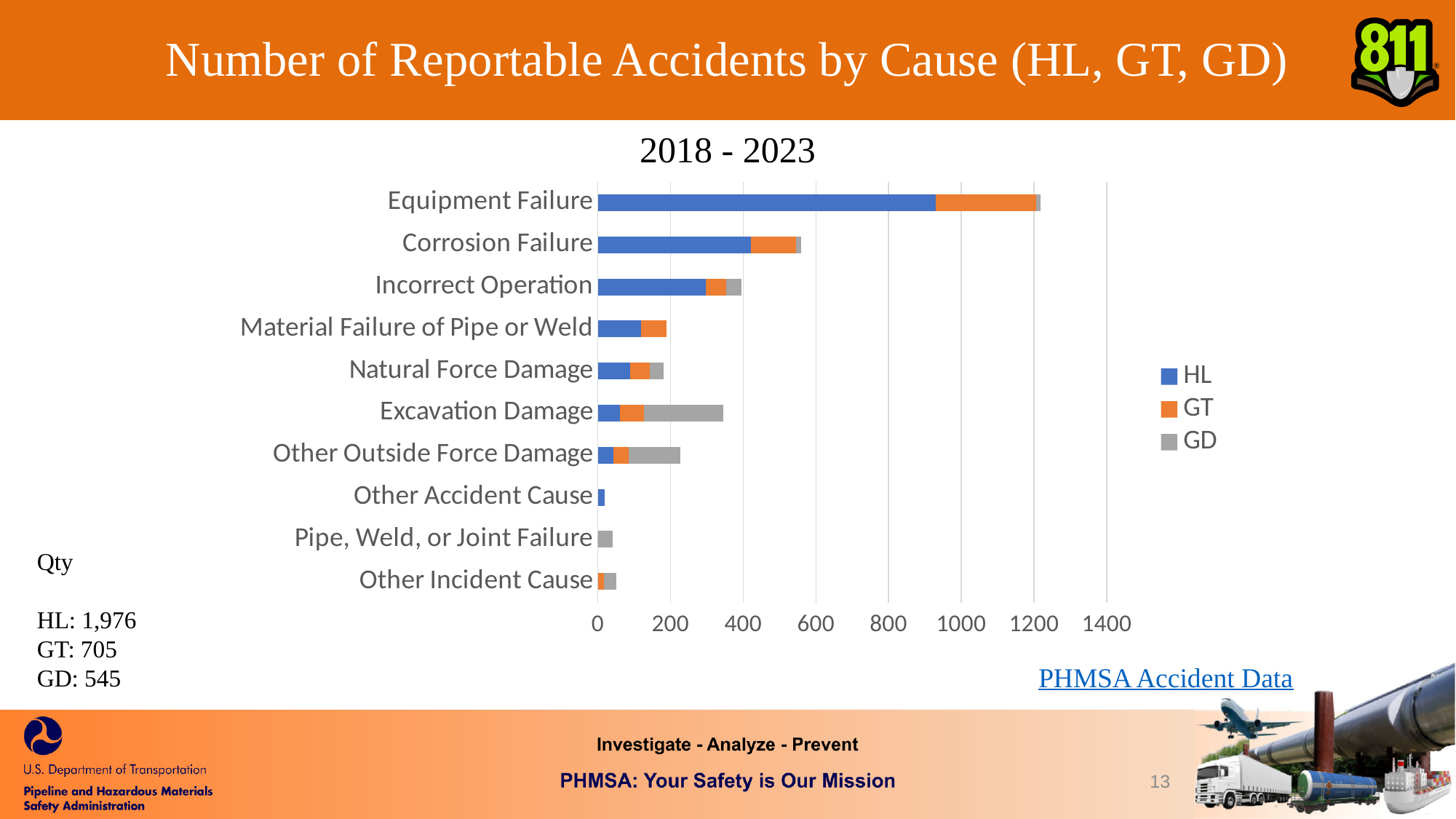
Is the total value for Equipment Failure greater or less than 1000? greater Is the total value for Natural Force Damage greater or less than 400? less Which cause category has the lowest total number of reportable accidents? Other Accident Cause Which has a larger total, Excavation Damage or Other Outside Force Damage? Excavation Damage What kind of chart is shown on the slide? Stacked bar chart Which has a larger total, Corrosion Failure or Incorrect Operation? Corrosion Failure How many cause categories are plotted on the chart? 10 What time period does the chart title indicate? 2018 - 2023 Which cause category has the highest total number of reportable accidents? Equipment Failure Is the total value for Excavation Damage greater or less than 200? greater How many series does the chart legend list? 3